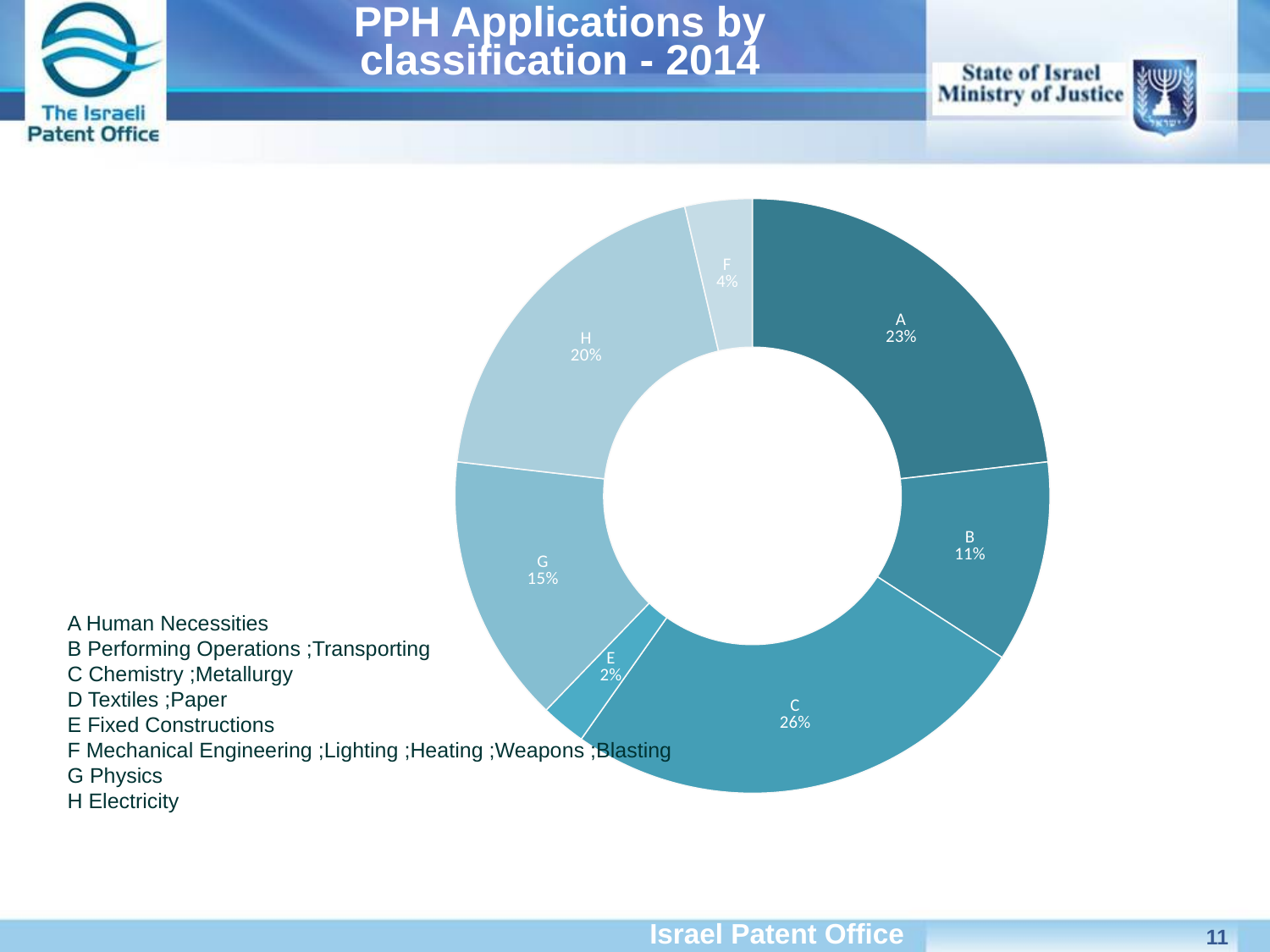
What percentage is shown for classification H (Electricity)? 20% What type of chart is used on this slide? Doughnut chart Which classification has the smallest share shown on the chart? E What percentage is shown for classification A (Human Necessities)? 23% What share of PPH applications does classification C (Chemistry; Metallurgy) account for? 26% What percentage is shown for classification E (Fixed Constructions)? 2% How many classification slices are shown on the chart? 7 What is the difference in percentage points between classification C and classification A? 3 Which classification has the largest share of PPH applications in 2014? C What is the title of the chart on this slide? PPH Applications by classification - 2014 Which has a larger share, classification B or classification G? G What is the difference in percentage points between classification H and classification G? 5